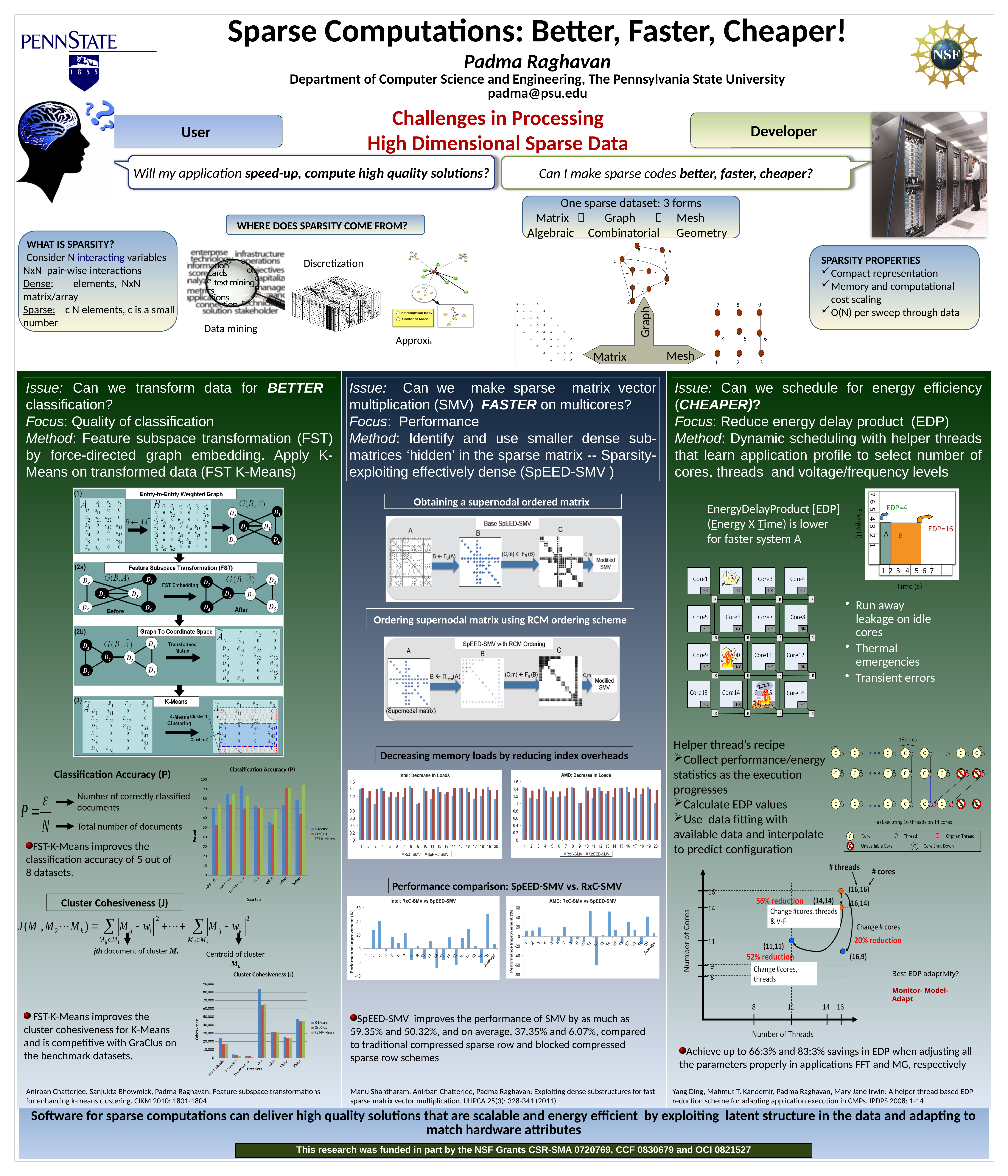
What kind of chart is the 'Classification Accuracy (P)' chart? bar chart In the 'Cluster Cohesiveness (J)' chart, is the K-Means value for dna greater or less than 70,000? greater In the Number of Cores vs Number of Threads chart, what reduction is labelled next to the point (14,14)? 56% reduction What is the y-axis label of the 'Classification Accuracy (P)' chart? Percent How many numbered categories are shown on the x axis of the 'AMD: Decrease in Loads' chart? 20 How many series does the legend of the 'Intel: Decrease in Loads' chart list? 2 In the 'Cluster Cohesiveness (J)' chart, which dataset has the highest K-Means value? dna In the 'Classification Accuracy (P)' chart, is the FST-K-Means value for 300txt greater or less than 80? greater In the 'Intel: Decrease in Loads' chart, is the RxC-SMV value for category 1 greater or less than 1? greater Which series does the legend of the 'Cluster Cohesiveness (J)' chart list? K-Means, GraClus, FST-K-Means In the Energy vs Time chart in the right column, what is the EDP value labelled for system A? EDP=4 How many series does the legend of the 'Classification Accuracy (P)' chart list? 3